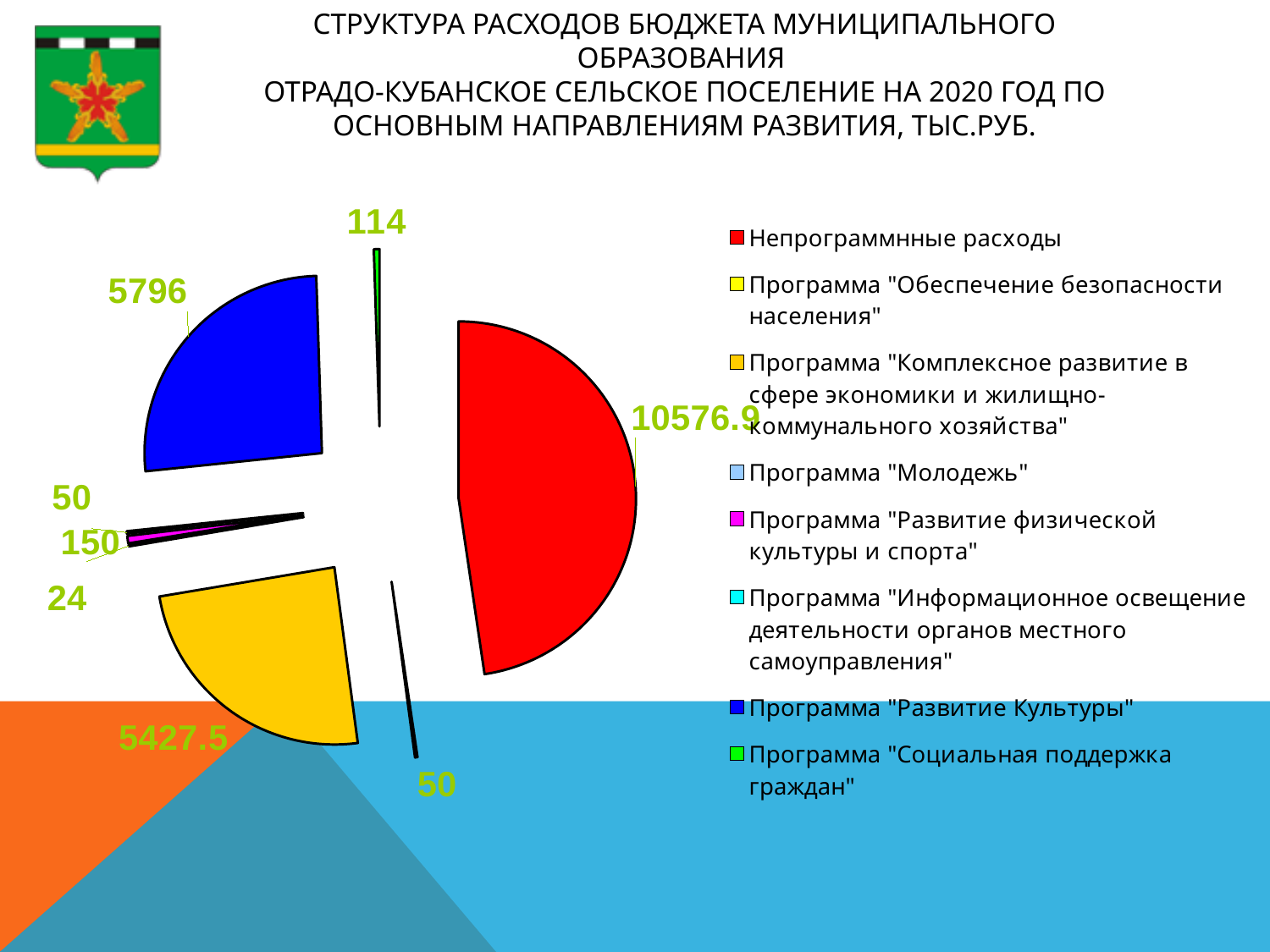
What is the difference between the value for Программа "Развитие Культуры" (5796) and Программа "Социальная поддержка граждан" (114)? 5682 What is the value of the red slice, Непрограммные расходы? 10576.9 Which category has the largest slice of the pie? Непрограммные расходы What is the difference between the value for Непрограммные расходы (10576.9) and Программа "Развитие Культуры" (5796)? 4780.9 What kind of chart is shown on the slide? pie chart What is the value for Программа "Социальная поддержка граждан" (the green slice)? 114 Which is larger: Непрограммные расходы or Программа "Развитие Культуры"? Непрограммные расходы How many slices does the pie chart have? 8 How many entries does the legend of the pie chart list? 8 What is the value for Программа "Развитие Культуры" (the blue slice)? 5796 What colour is the slice for Непрограммные расходы? red What is the smallest value labelled on the pie chart? 24